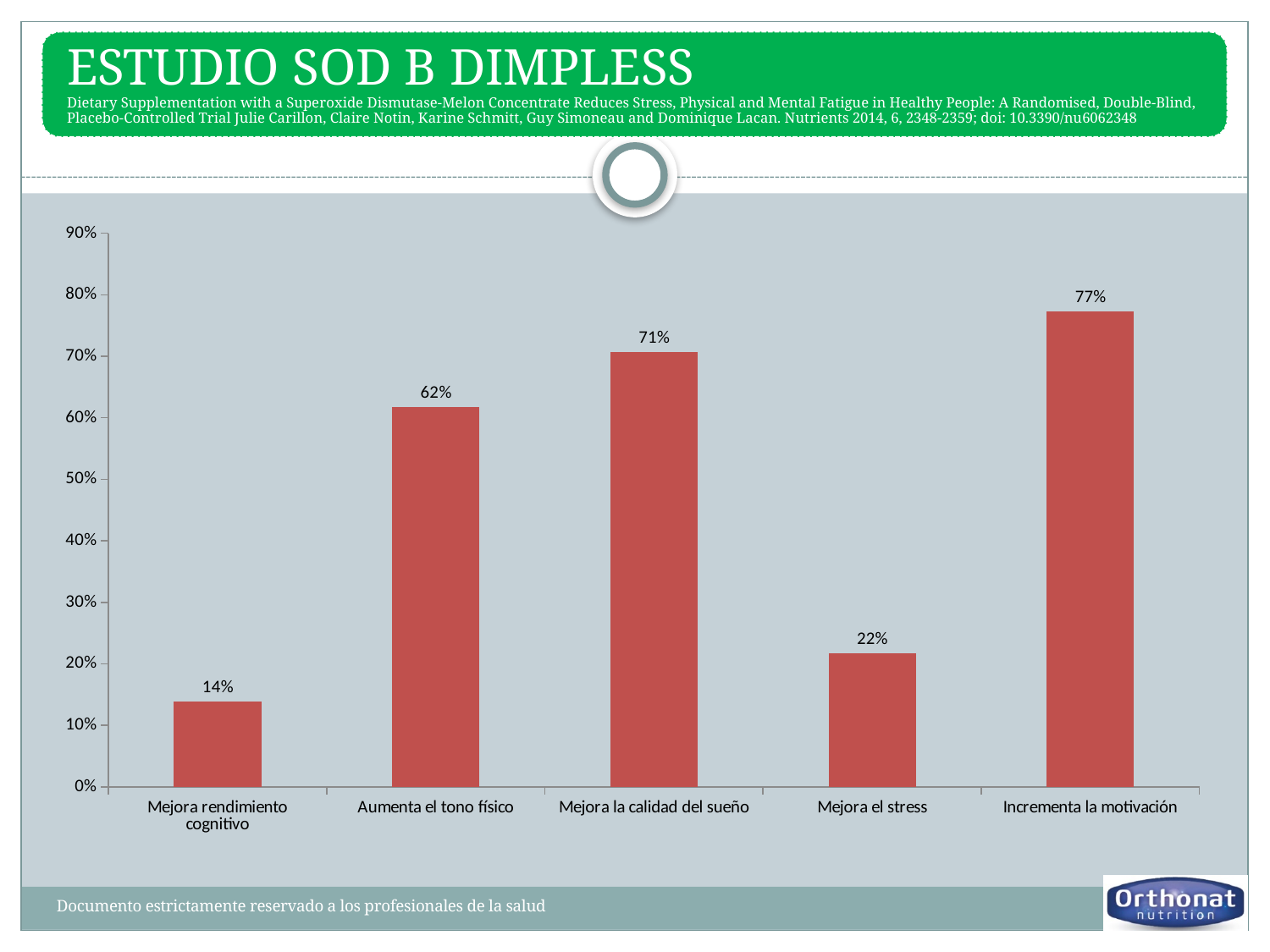
What kind of chart is shown on the slide? bar chart Is the value for Mejora la calidad del sueño greater or less than 70%? greater What is the value for Aumenta el tono físico? 62% Which is larger, the value for Aumenta el tono físico or the value for Mejora el stress? Aumenta el tono físico What is the value for Mejora el stress? 22% What is the difference between the values for Incrementa la motivación and Mejora la calidad del sueño? 6% Which category has the highest value? Incrementa la motivación How many categories are shown on the x axis? 5 Which category has the lowest value? Mejora rendimiento cognitivo What is the value for Mejora la calidad del sueño? 71% What is the value for Mejora rendimiento cognitivo? 14% What is the highest value shown on the y axis? 90%